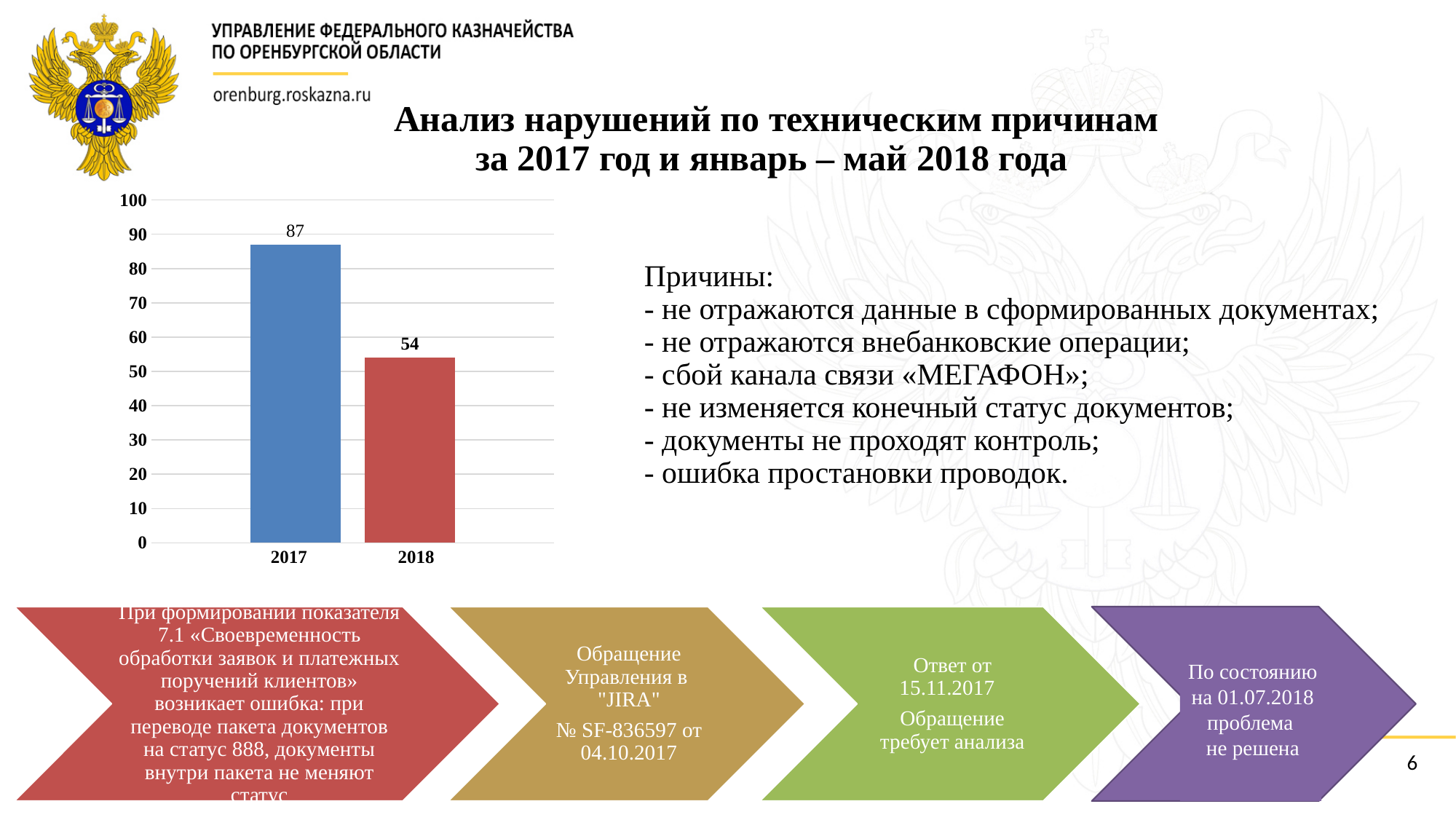
Do the values rise or fall from 2017 to 2018? fall Is the value for 2018 greater or less than 60? less Which category has the highest value? 2017 Is the value for 2017 greater or less than 80? greater Which is larger, the value for 2017 or the value for 2018? 2017 What is the difference between the values for 2017 and 2018? 33 What is the value for 2018? 54 Which category has the lowest value? 2018 What kind of chart is shown on the slide? bar chart What colour is the bar for 2018? red How many categories are shown on the chart? 2 What is the value for 2017? 87